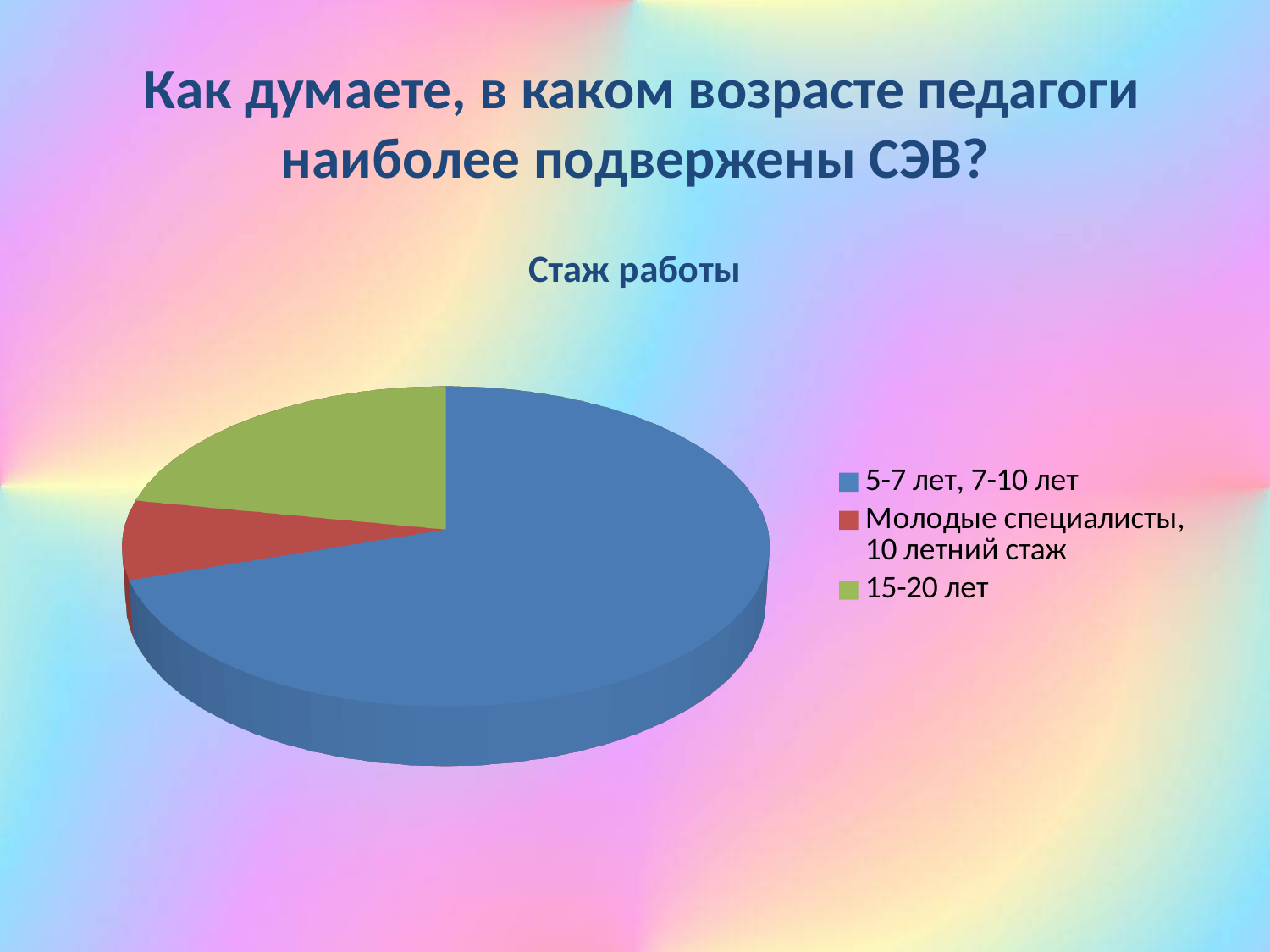
Which slice is larger: "5-7 лет, 7-10 лет" or "15-20 лет"? 5-7 лет, 7-10 лет Which category has the largest share of the pie? 5-7 лет, 7-10 лет What colour is the slice for "15-20 лет"? Green Which category has the smallest share of the pie? Молодые специалисты, 10 летний стаж What kind of chart is shown on the slide? Pie chart How many slices does the pie chart have? 3 What is the title of the chart? Стаж работы How many entries does the legend list? 3 Which slice is larger: "15-20 лет" or "Молодые специалисты, 10 летний стаж"? 15-20 лет Does the "5-7 лет, 7-10 лет" slice take up more or less than half of the pie? more